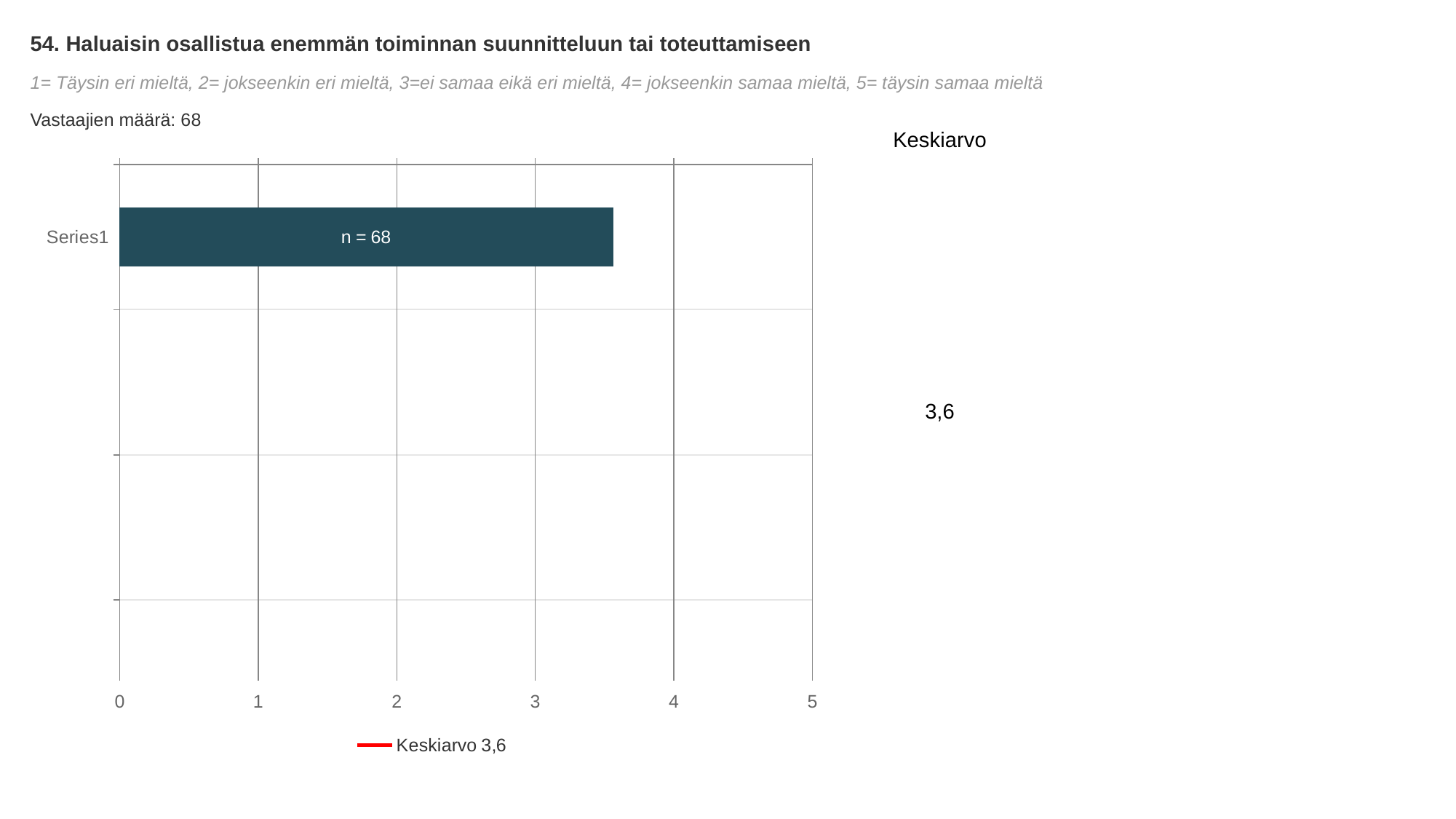
What data label is printed on the Series1 bar? n = 68 What is the highest value shown on the horizontal axis? 5 How many respondents (Vastaajien määrä) are reported on the slide? 68 What does the legend entry below the chart say? Keskiarvo 3,6 What kind of chart is shown on the slide? bar chart Is the value for Series1 greater or less than 4? less What is the category label of the single bar in the chart? Series1 What is the Keskiarvo (mean) value shown on the slide? 3,6 How many bars are plotted in the chart? 1 Is the value for Series1 greater or less than 3? greater